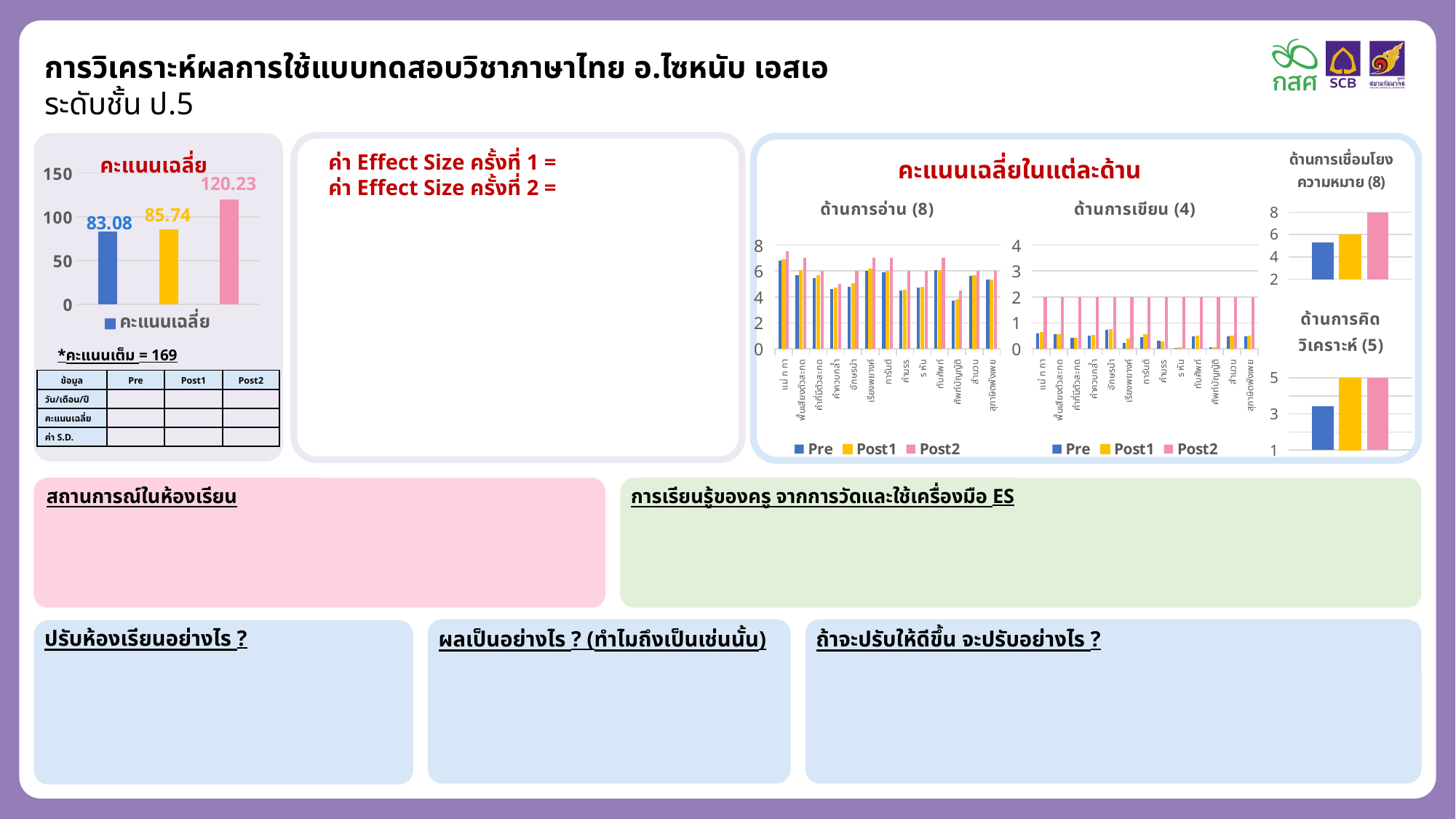
In the chart titled ด้านการเชื่อมโยงความหมาย (8), what value does the pink bar reach? 8 In the chart titled คะแนนเฉลี่ย on the left, which bar has the highest value? The pink bar (120.23) In the chart titled คะแนนเฉลี่ย on the left, how many bars are plotted? 3 In the chart titled ด้านการอ่าน (8), how many series does the legend list? 3 In the chart titled ด้านการคิดวิเคราะห์ (5), is the value of the blue bar greater or less than 3? greater In the chart titled คะแนนเฉลี่ย on the left, what is the value of the yellow bar? 85.74 In the chart titled คะแนนเฉลี่ย on the left, what is the value of the first (blue) bar? 83.08 In the chart titled คะแนนเฉลี่ย on the left, what is the difference between the pink bar and the blue bar? 37.15 In the chart titled คะแนนเฉลี่ย on the left, what is the value of the pink bar? 120.23 What kind of chart is the chart titled ด้านการเขียน (4)? Bar chart In the chart titled ด้านการเขียน (4), what are the legend entries? Pre, Post1, Post2 In the chart titled คะแนนเฉลี่ย on the left, do the values rise or fall from left to right? Rise